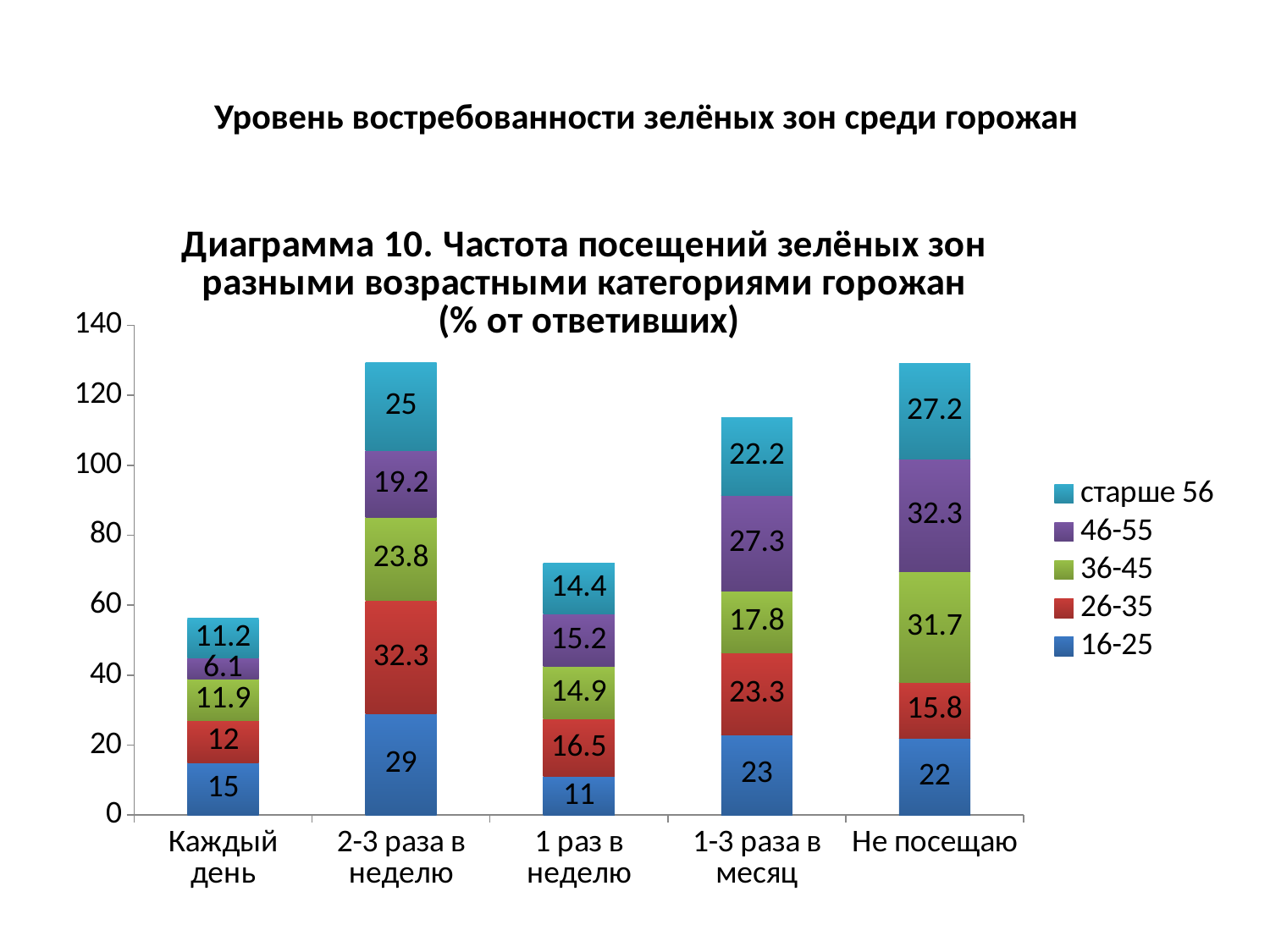
What is the total of the stacked bar for '1 раз в неделю'? 72 How many series does the legend list? 5 Is the total stacked bar for '1-3 раза в месяц' greater or less than 100? greater Which category has the lowest total stacked bar? Каждый день What is the value for the 16-25 age group in the '2-3 раза в неделю' category? 29 How many categories are shown on the x axis? 5 What is the value for the 'старше 56' age group in the 'Не посещаю' category? 27.2 In which category is the value for the 16-25 age group the highest? 2-3 раза в неделю What is the difference between the 26-35 values for '2-3 раза в неделю' and '1 раз в неделю'? 15.8 For the 36-45 age group, which is larger: 'Не посещаю' or '1-3 раза в месяц'? Не посещаю What is the total of the stacked bar for 'Каждый день'? 56.2 What is the value for the 46-55 age group in the 'Каждый день' category? 6.1